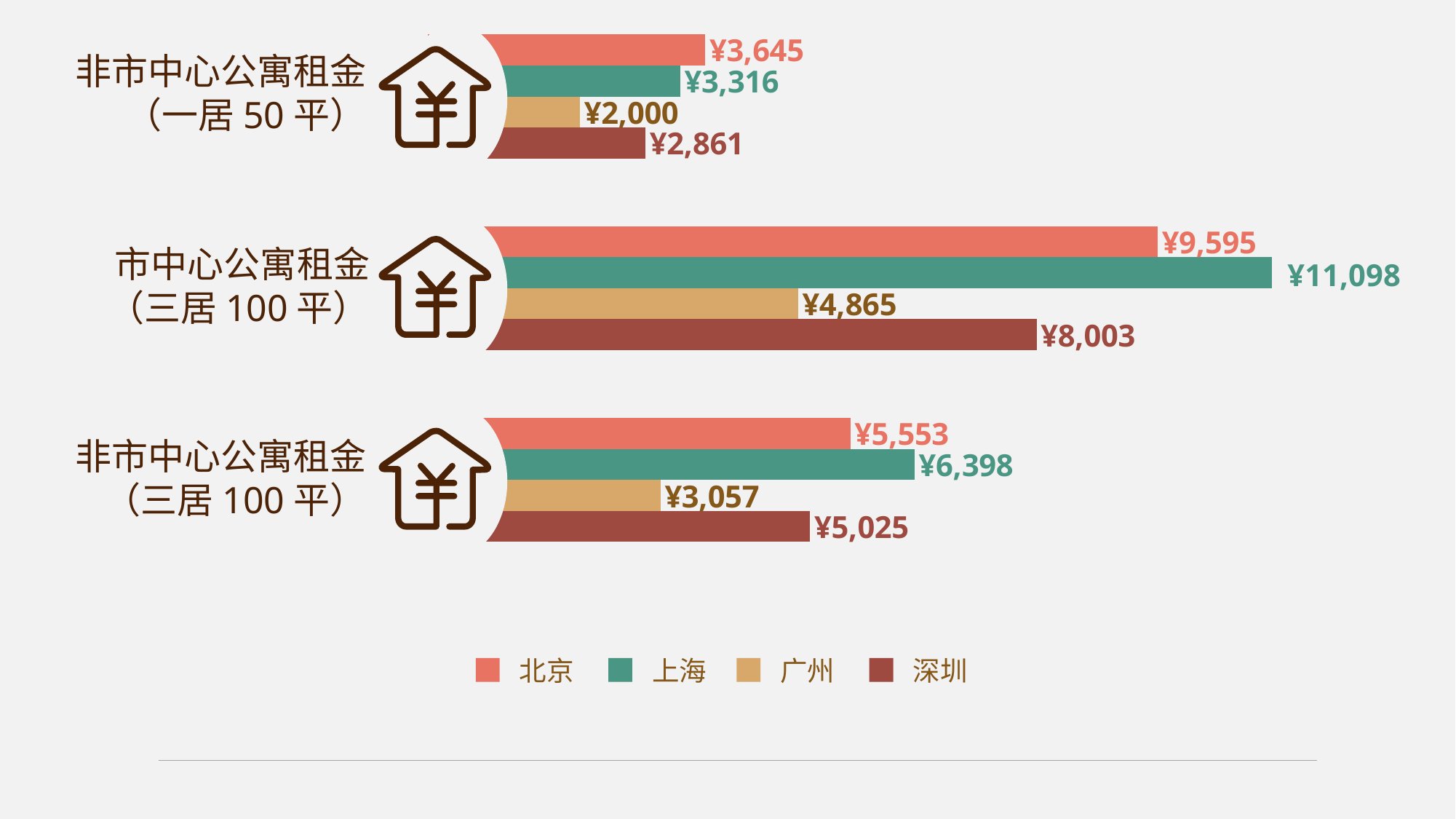
How many categories are shown on the chart? 3 What is the difference between 上海 and 北京 in the 非市中心公寓租金（三居 100 平）category? ¥845 In the 非市中心公寓租金（一居 50 平）category, which is larger, 北京 or 上海? 北京 Which colour represents 广州 in the legend? Tan/gold How many series does the legend list? 4 What is the value for 上海 in the 市中心公寓租金（三居 100 平）category? ¥11,098 What is the difference between 北京 and 深圳 in the 市中心公寓租金（三居 100 平）category? ¥1,592 Which city has the lowest value in the 非市中心公寓租金（三居 100 平）category? 广州 Which city has the highest value in the 市中心公寓租金（三居 100 平）category? 上海 What is the value for 深圳 in the 非市中心公寓租金（三居 100 平）category? ¥5,025 What kind of chart is shown on the slide? Bar chart What is the value for 广州 in the 非市中心公寓租金（一居 50 平）category? ¥2,000